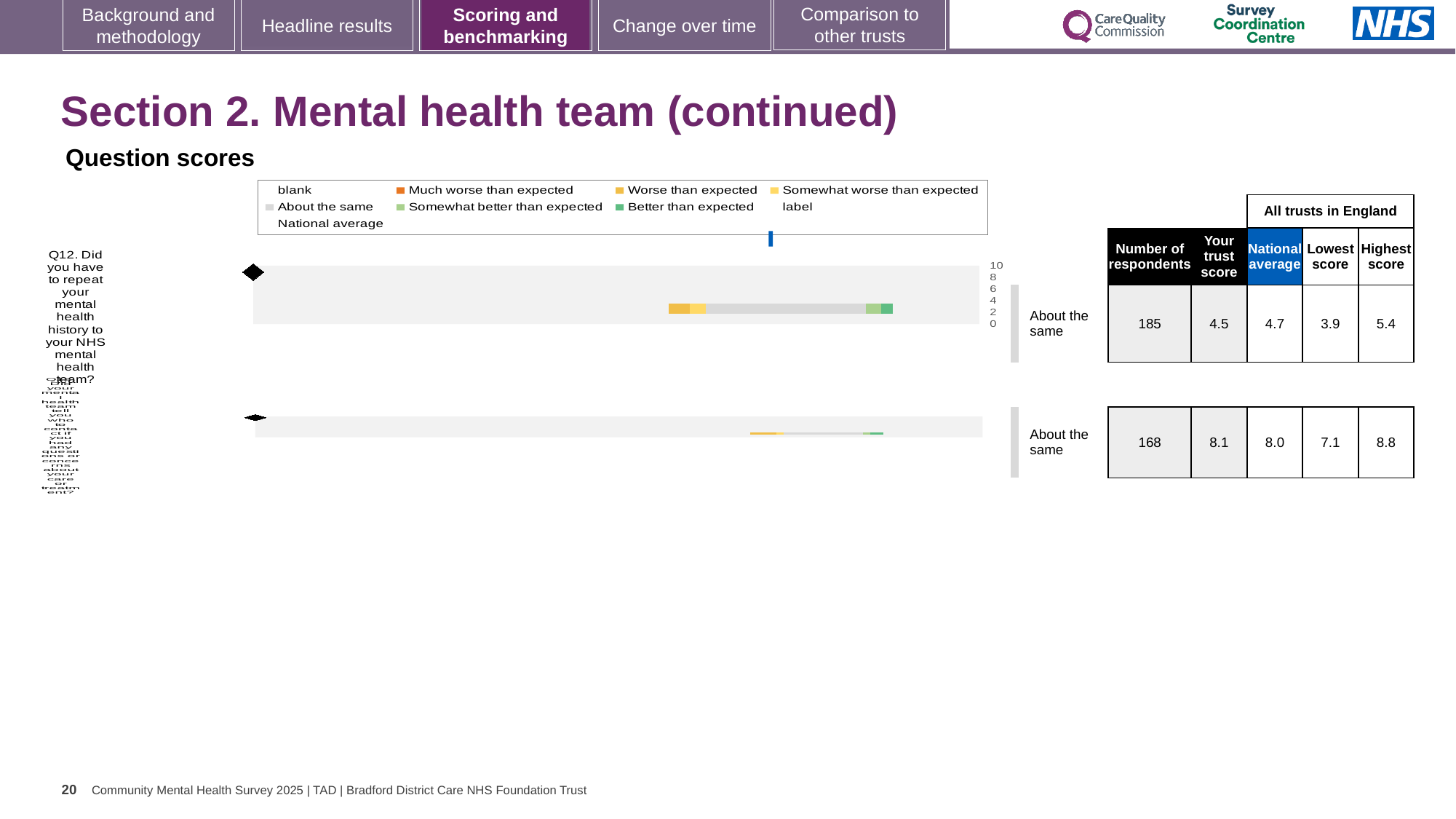
For Q12, which is larger: the trust score or the national average? National average What kind of chart is used to show the question scores? Bar chart For Q12, what is the difference between the highest and lowest scores among all trusts in England? 1.5 What is the national average score for Q12? 4.7 For Q12, how much higher is the national average than the trust score? 0.2 What benchmark category is shown for Q12? About the same What is the trust score for Q12 (Did you have to repeat your mental health history to your NHS mental health team?)? 4.5 What is the highest score among all trusts in England for Q12? 5.4 How many respondents answered Q12? 185 How many question rows are plotted in the chart? 2 What colour represents 'Much worse than expected' in the legend? Orange What is the lowest score among all trusts in England for Q12? 3.9